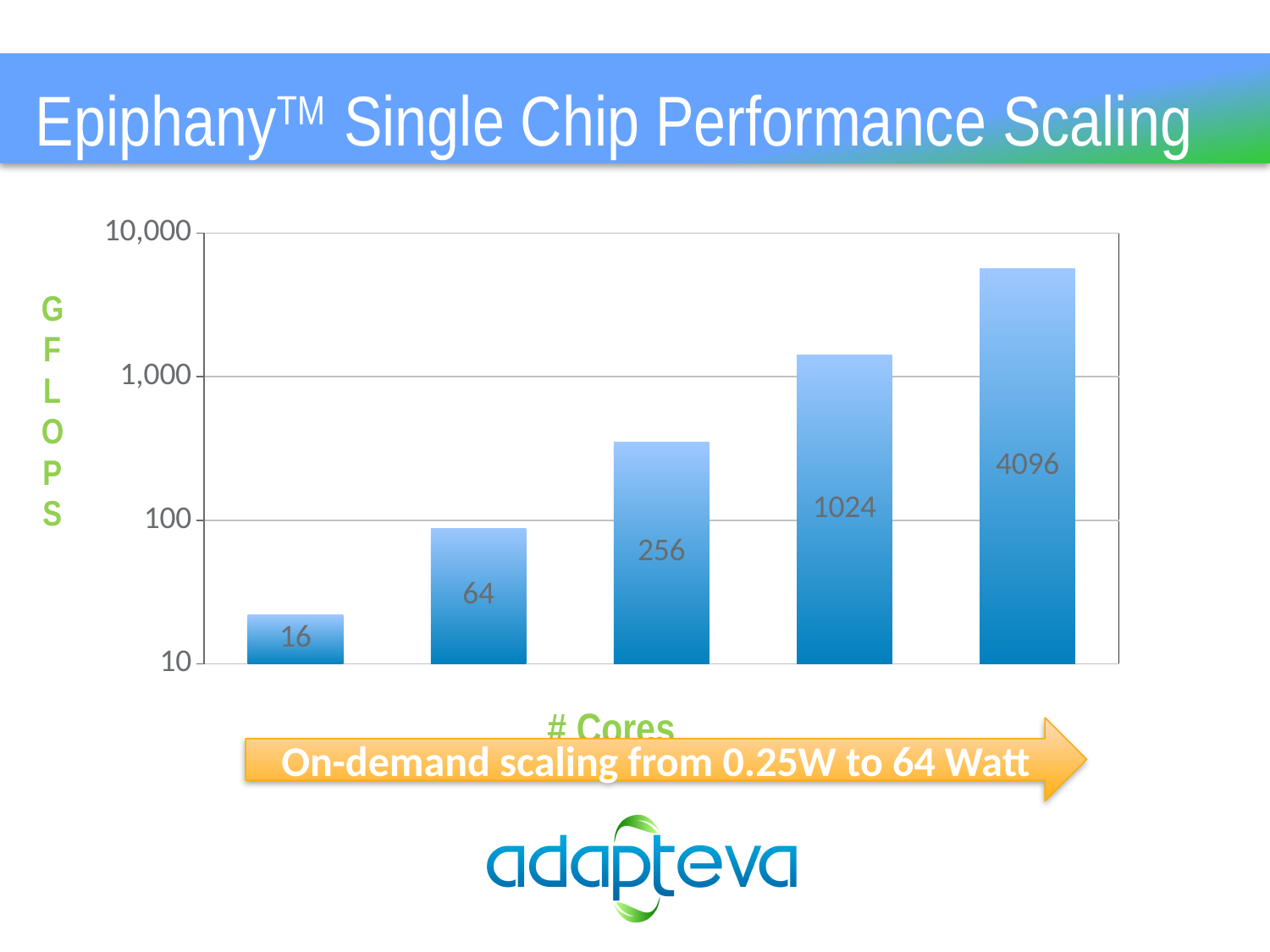
Is the GFLOPS value for 256 cores greater or less than 1,000? less Is the GFLOPS value for 16 cores greater or less than 100? less Which core count has the highest GFLOPS value? 4096 Which core count has the lowest GFLOPS value? 16 How many bars (core counts) are plotted in the chart? 5 Is the GFLOPS value for 4096 cores greater or less than 10,000? less Do the GFLOPS values rise or fall as the number of cores increases along the x axis? rise Which has the larger GFLOPS value, 64 cores or 1024 cores? 1024 cores What kind of chart is shown on the slide? bar chart What is the label of the x axis of the chart? # Cores